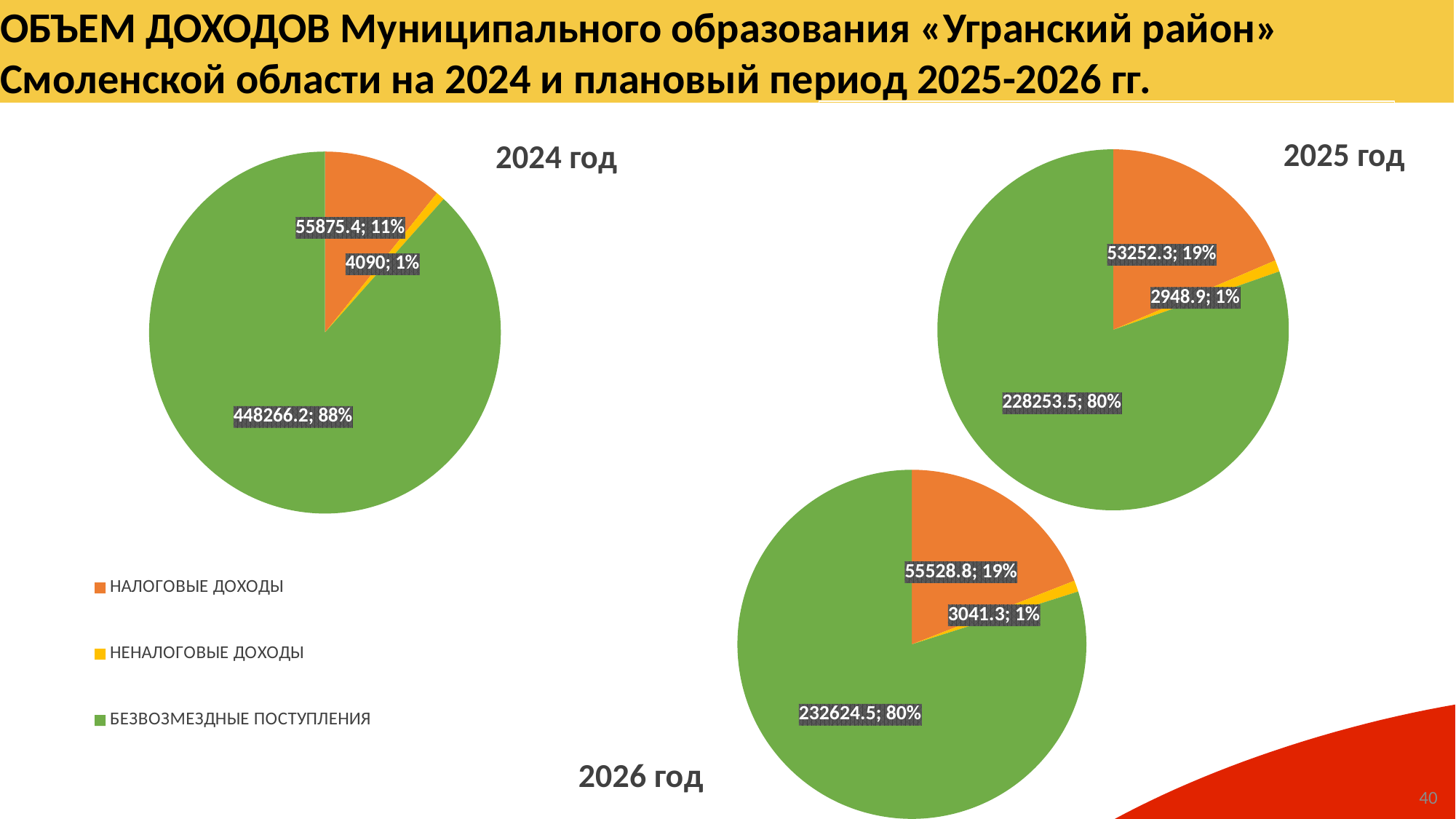
How many entries does the legend list? 3 In the 2024 год chart, what is the value for НАЛОГОВЫЕ ДОХОДЫ? 55875.4 In the 2026 год chart, what is the value for БЕЗВОЗМЕЗДНЫЕ ПОСТУПЛЕНИЯ? 232624.5 How many slices does the 2024 год chart have? 3 What is the difference between the НАЛОГОВЫЕ ДОХОДЫ value in the 2026 год chart and in the 2025 год chart? 2276.5 In the 2025 год chart, what is the value for НЕНАЛОГОВЫЕ ДОХОДЫ? 2948.9 What type of chart is used for 2025 год? Pie chart In the 2025 год chart, what share of the pie is НАЛОГОВЫЕ ДОХОДЫ? 19% In the 2025 год chart, which is larger: НАЛОГОВЫЕ ДОХОДЫ or НЕНАЛОГОВЫЕ ДОХОДЫ? НАЛОГОВЫЕ ДОХОДЫ In the 2026 год chart, which category has the smallest slice? НЕНАЛОГОВЫЕ ДОХОДЫ In the 2024 год chart, what share of the pie is БЕЗВОЗМЕЗДНЫЕ ПОСТУПЛЕНИЯ? 88% In the 2024 год chart, which category has the largest slice? БЕЗВОЗМЕЗДНЫЕ ПОСТУПЛЕНИЯ